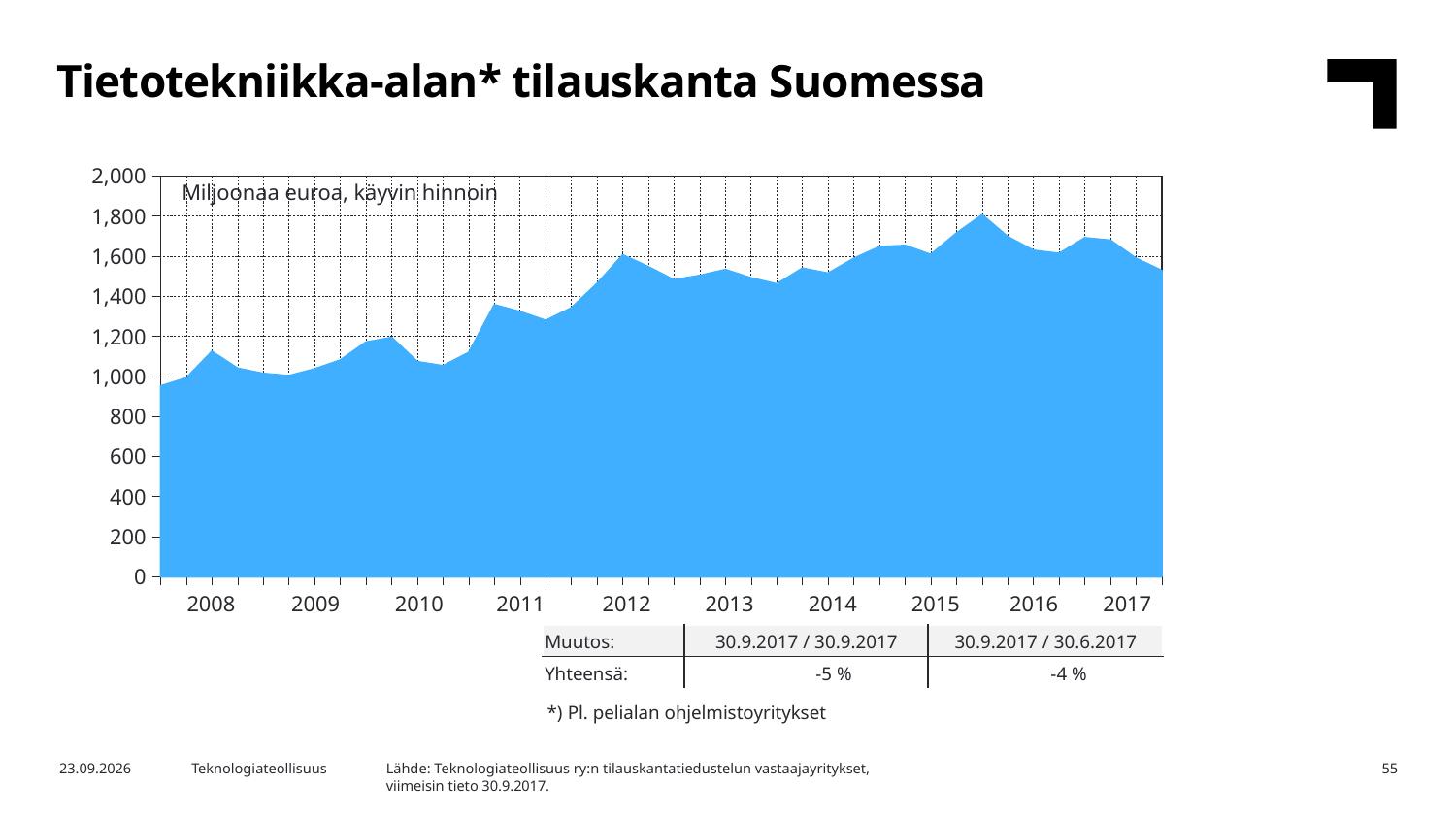
What is the change (Muutos) for 30.9.2017 / 30.6.2017 shown in the table? -4 % Is the peak value of the series greater or less than 1,600? greater Overall, does the order backlog rise or fall from 2008 to 2017? rise Is the value at the end of the series in 2017 greater or less than 1,400? greater How many year labels are shown on the x axis? 10 What is the title of the chart? Tietotekniikka-alan* tilauskanta Suomessa What kind of chart is shown on the slide? area chart What unit is stated inside the chart area? Miljoonaa euroa, käyvin hinnoin Is the value at the start of 2008 greater or less than 1,200? less What is the highest value shown on the y axis? 2,000